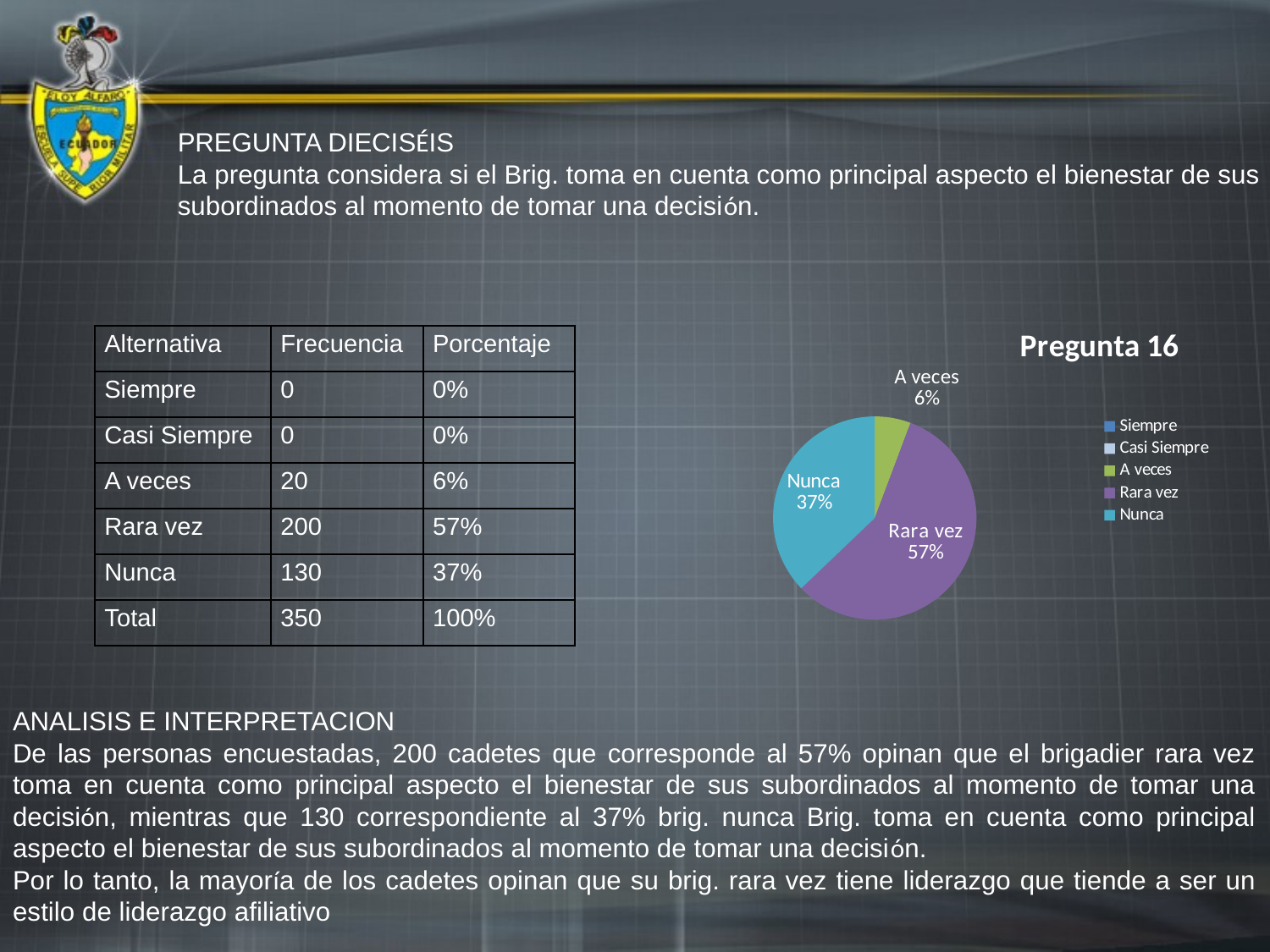
Which labelled slice is the smallest in the pie chart? A veces What is the difference in percentage points between the Rara vez and Nunca slices? 20 Which category has the largest slice in the pie chart? Rara vez How many entries does the chart legend list? 5 What is the title of the chart? Pregunta 16 What percentage does the Rara vez slice show in the pie chart? 57% Which is larger in the pie chart, Nunca or A veces? Nunca How many slices with labels are visible in the pie chart? 3 What share of the pie does the Rara vez slice represent? 57% What kind of chart is shown on the slide? pie chart What percentage does the Nunca slice show in the pie chart? 37% What percentage does the A veces slice show in the pie chart? 6%